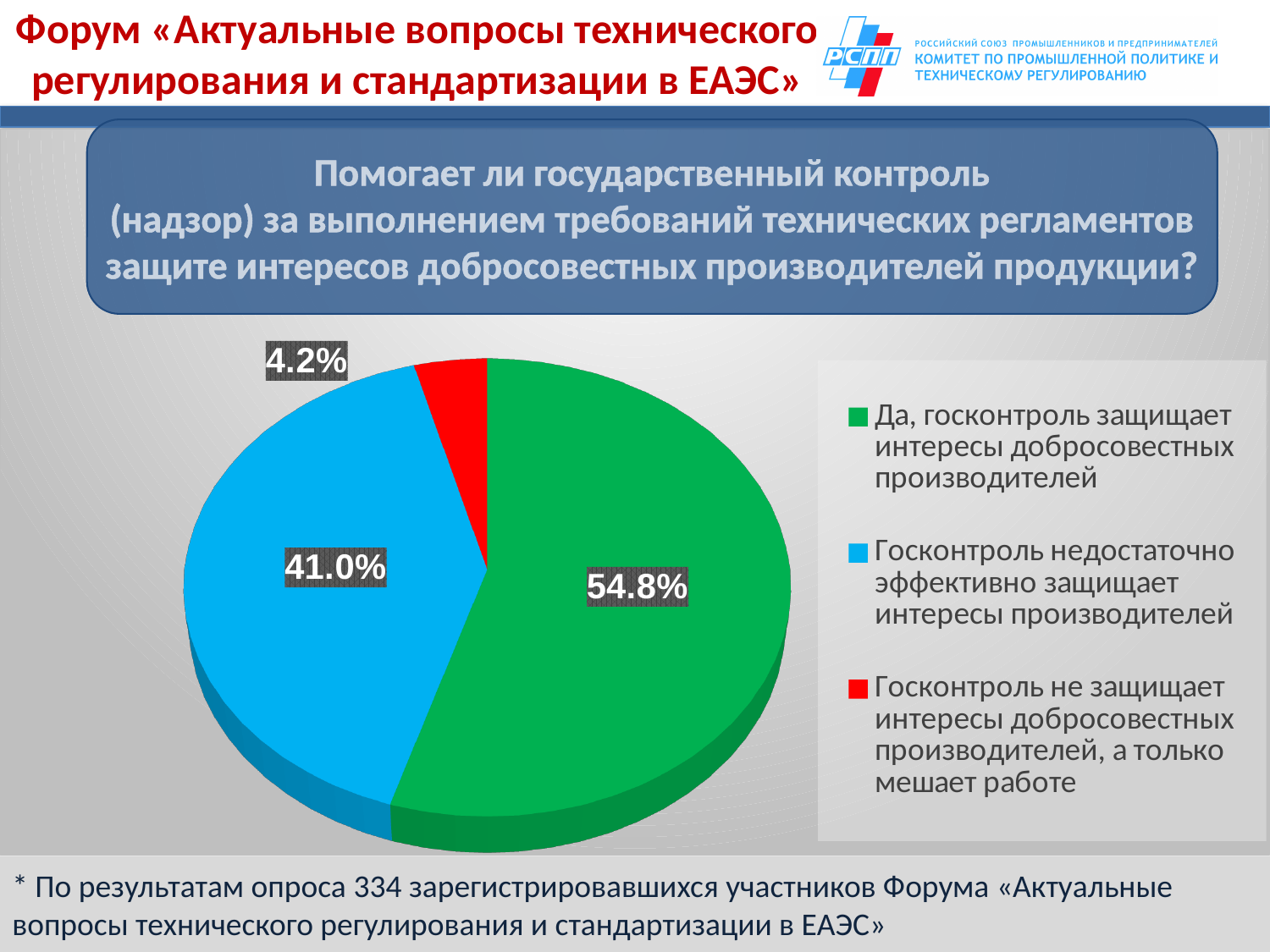
Which is larger: the share for "Да, госконтроль защищает интересы добросовестных производителей" or the share for "Госконтроль недостаточно эффективно защищает интересы производителей"? Да, госконтроль защищает интересы добросовестных производителей Which answer option has the largest share of the pie? Да, госконтроль защищает интересы добросовестных производителей What kind of chart is shown on the slide? Pie chart What colour is the slice representing "Госконтроль не защищает интересы добросовестных производителей, а только мешает работе"? Red What share of respondents answered "Госконтроль недостаточно эффективно защищает интересы производителей"? 41.0% What share of respondents answered "Да, госконтроль защищает интересы добросовестных производителей"? 54.8% Which answer option has the smallest share of the pie? Госконтроль не защищает интересы добросовестных производителей, а только мешает работе How many slices does the pie chart have? 3 What share of respondents answered "Госконтроль не защищает интересы добросовестных производителей, а только мешает работе"? 4.2% How many registered Forum participants were surveyed, according to the footnote? 334 What is the difference in percentage points between the blue slice (41.0%) and the red slice (4.2%)? 36.8 What is the difference in percentage points between the green slice (54.8%) and the blue slice (41.0%)? 13.8